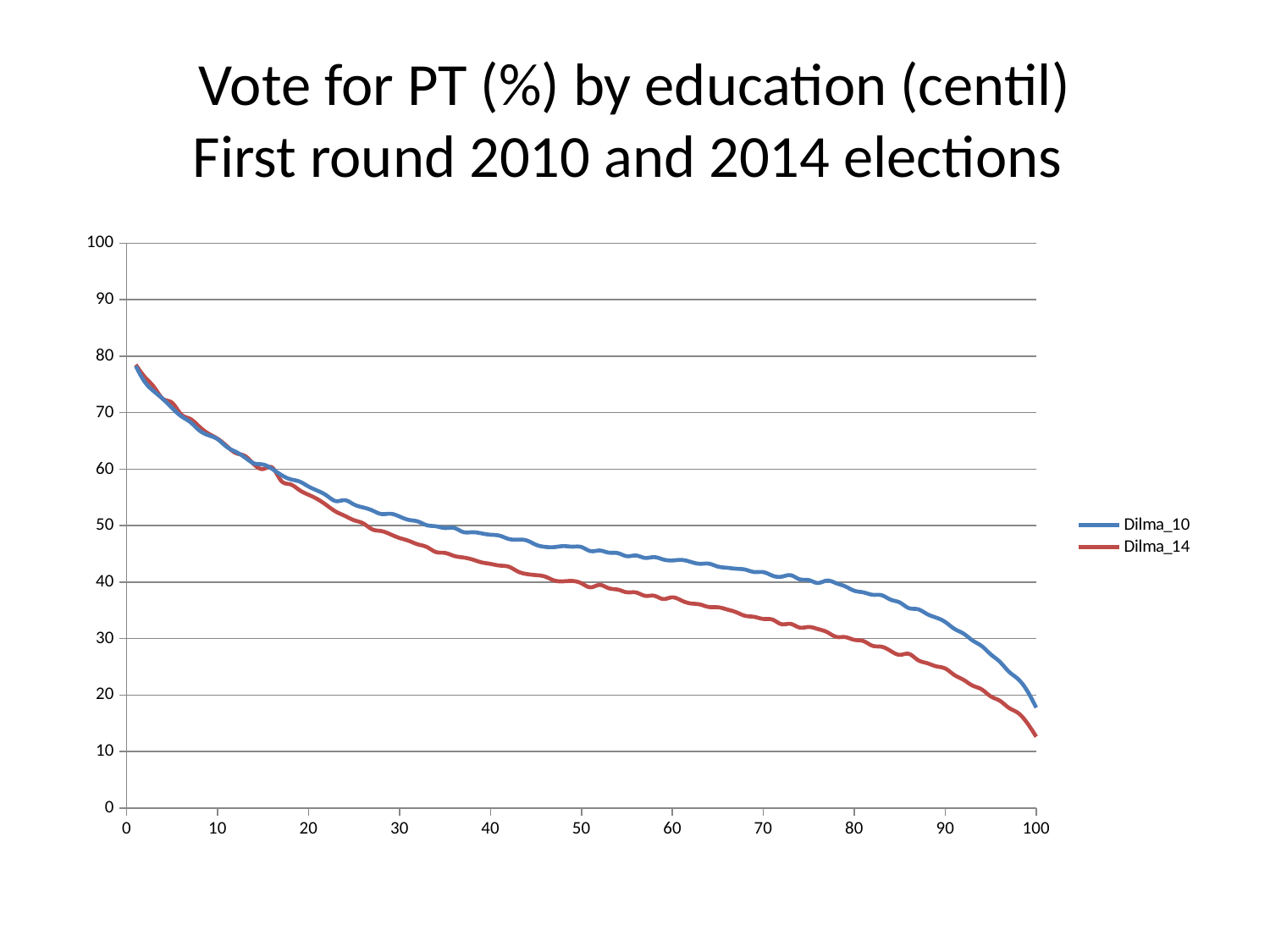
Is the value for Dilma_14 at centile 90 greater or less than 30? less Do the values of the Dilma_10 series rise or fall along the x axis? fall Is the value for Dilma_10 at centile 30 greater or less than 50? greater Is the value for Dilma_10 at centile 100 greater or less than 20? less At centile 60, which series has the larger value, Dilma_10 or Dilma_14? Dilma_10 What are the two series named in the legend? Dilma_10 and Dilma_14 What kind of chart is shown on the slide? line chart Do the values of the Dilma_14 series rise or fall as the education centile increases along the x axis? fall How many series does the legend list? 2 At centile 90, which series has the larger value, Dilma_10 or Dilma_14? Dilma_10 What is the title of the chart? Vote for PT (%) by education (centil) First round 2010 and 2014 elections